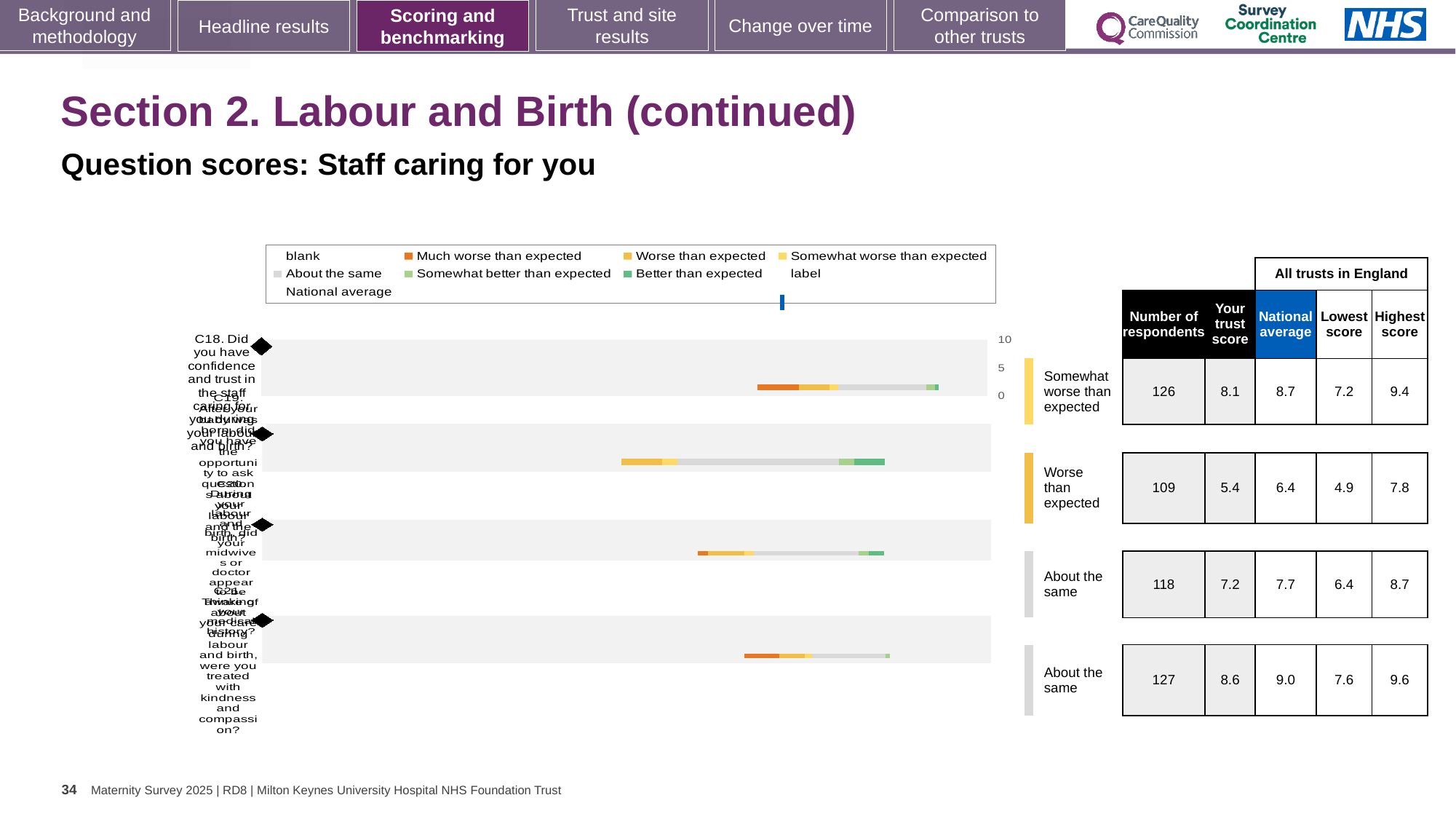
What is the trust score for the row rated 'Worse than expected'? 5.4 What kind of chart is shown on the slide? bar chart Which rating row has the lowest trust score? Worse than expected In the chart legend, what colour represents 'Better than expected'? green What is the highest score among all trusts in England for the row rated 'Somewhat worse than expected'? 9.4 Which is larger: the trust score for the 'Somewhat worse than expected' row or the trust score for the 'Worse than expected' row? Somewhat worse than expected In the chart legend, what colour represents 'Much worse than expected'? orange What is the difference between the national average and the trust score for the row rated 'Worse than expected'? 1.0 How many horizontal bars are plotted in the chart? 4 What is the national average for the row rated 'Somewhat worse than expected'? 8.7 What is the number of respondents for the row rated 'Worse than expected'? 109 What is the difference between the highest score and the lowest score for the row rated 'Worse than expected'? 2.9